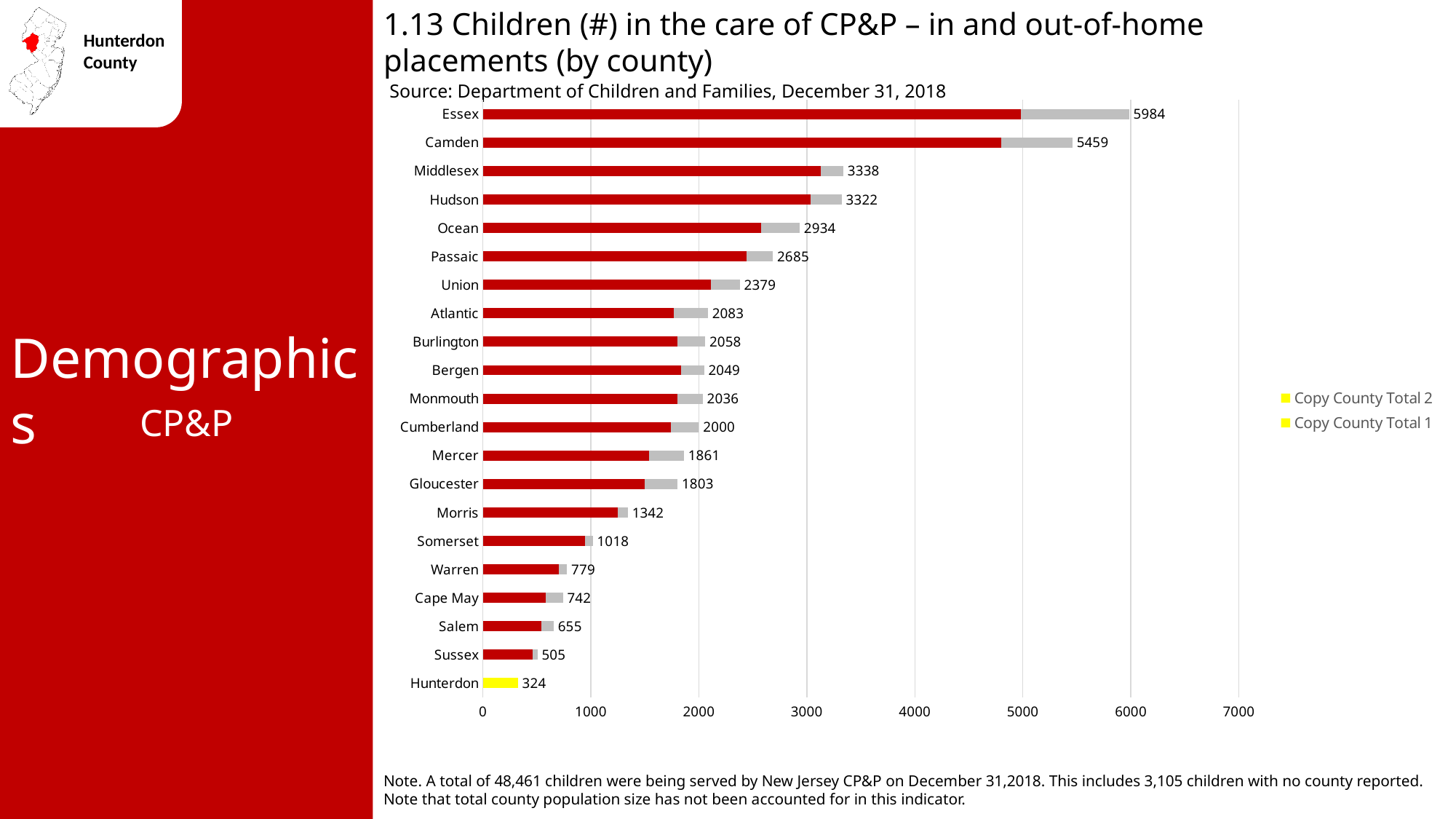
What value is labeled for Hunterdon county? 324 What is the difference between the totals for Essex and Camden? 525 What is the difference between the totals for Sussex and Hunterdon? 181 Which county has the highest total number of children in the care of CP&P? Essex What type of chart is shown on the slide? Stacked horizontal bar chart What is the total number of children in the care of CP&P shown for Essex county? 5984 Is the red (in-home) segment of the Essex bar greater or less than 4000? greater How many counties are shown in the chart? 21 Which county has a larger total, Passaic or Union? Passaic How many series does the legend list? 2 What is the value shown for Ocean county? 2934 Which county has the lowest total number of children in the care of CP&P? Hunterdon